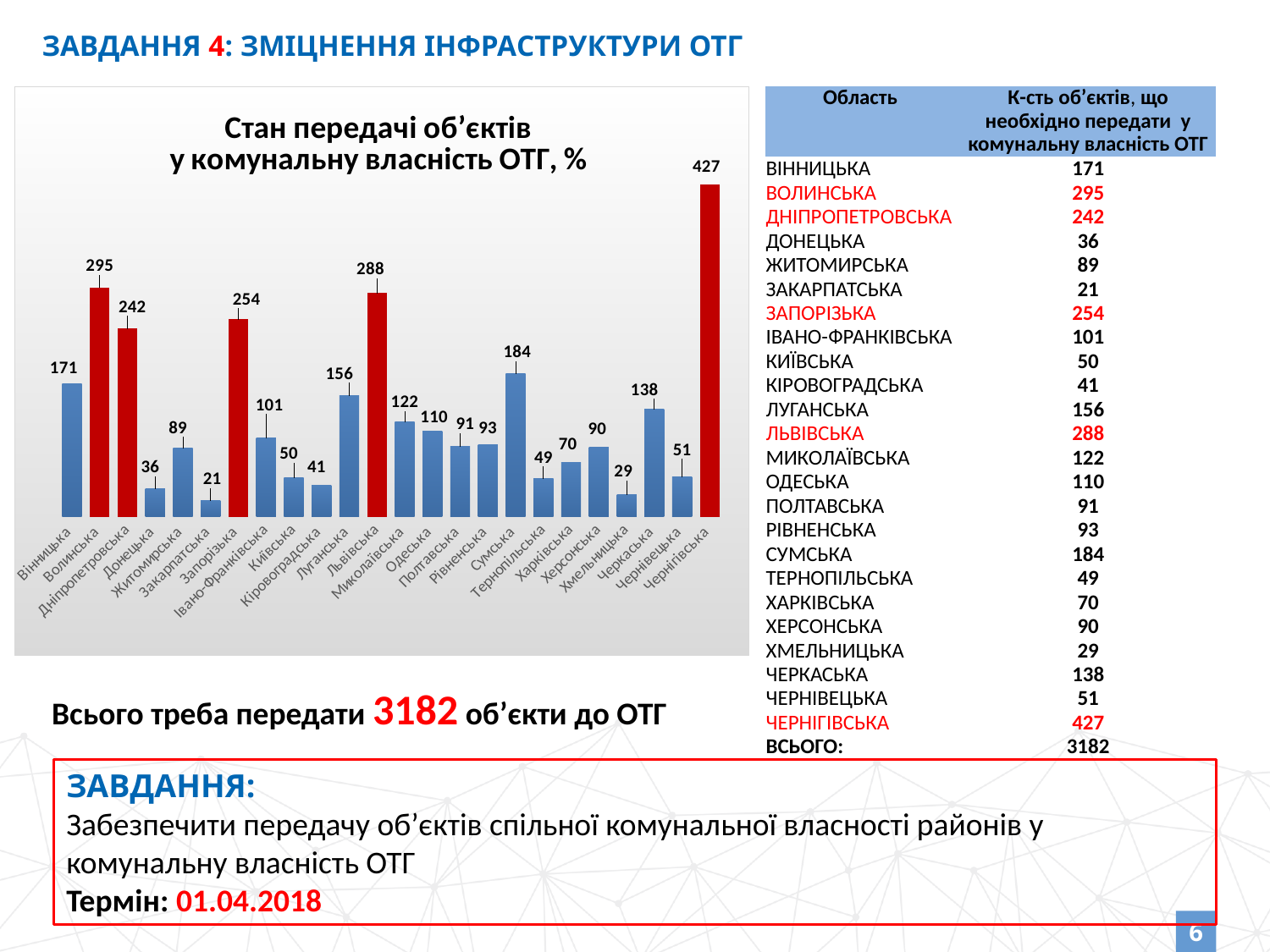
What is the value shown for Закарпатська in the chart? 21 What is the value shown for Чернігівська in the chart? 427 What is the value shown for Сумська in the chart? 184 Which category has the lowest value in the chart? Закарпатська How many bars in the chart are coloured red? 5 How many categories (regions) are plotted in the chart? 24 Which category has the highest value in the chart? Чернігівська What is the title of the chart? Стан передачі об'єктів у комунальну власність ОТГ, % Which has a larger value, Волинська or Львівська? Волинська What kind of chart is shown on the slide? Bar chart Which has a larger value, Луганська or Черкаська? Луганська What is the difference between the values for Чернігівська and Волинська? 132